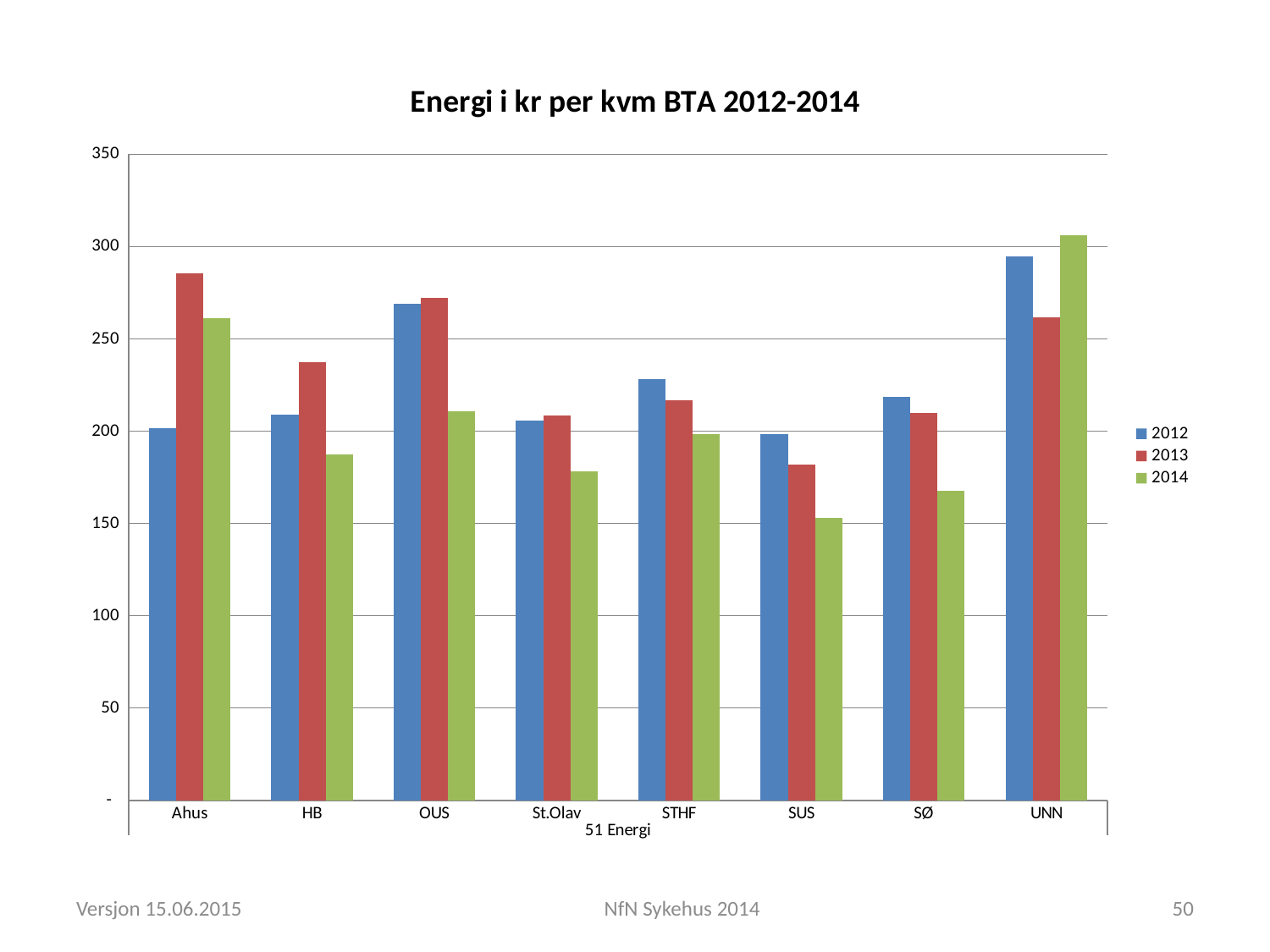
How many series does the legend list? 3 Which category has the highest value for the 2013 series? Ahus Is the 2014 value for SUS greater or less than 200? less Is the 2013 value for Ahus greater or less than 250? greater Which category has the highest value for the 2014 series? UNN Which category has the lowest value for the 2014 series? SUS For Ahus, which is larger: the 2012 value or the 2013 value? 2013 What is the title of the chart? Energi i kr per kvm BTA 2012-2014 Is the 2012 value for OUS greater or less than 250? greater Do the values for SUS rise or fall from 2012 to 2014? fall What kind of chart is shown on the slide? bar chart How many categories are shown on the x axis? 8